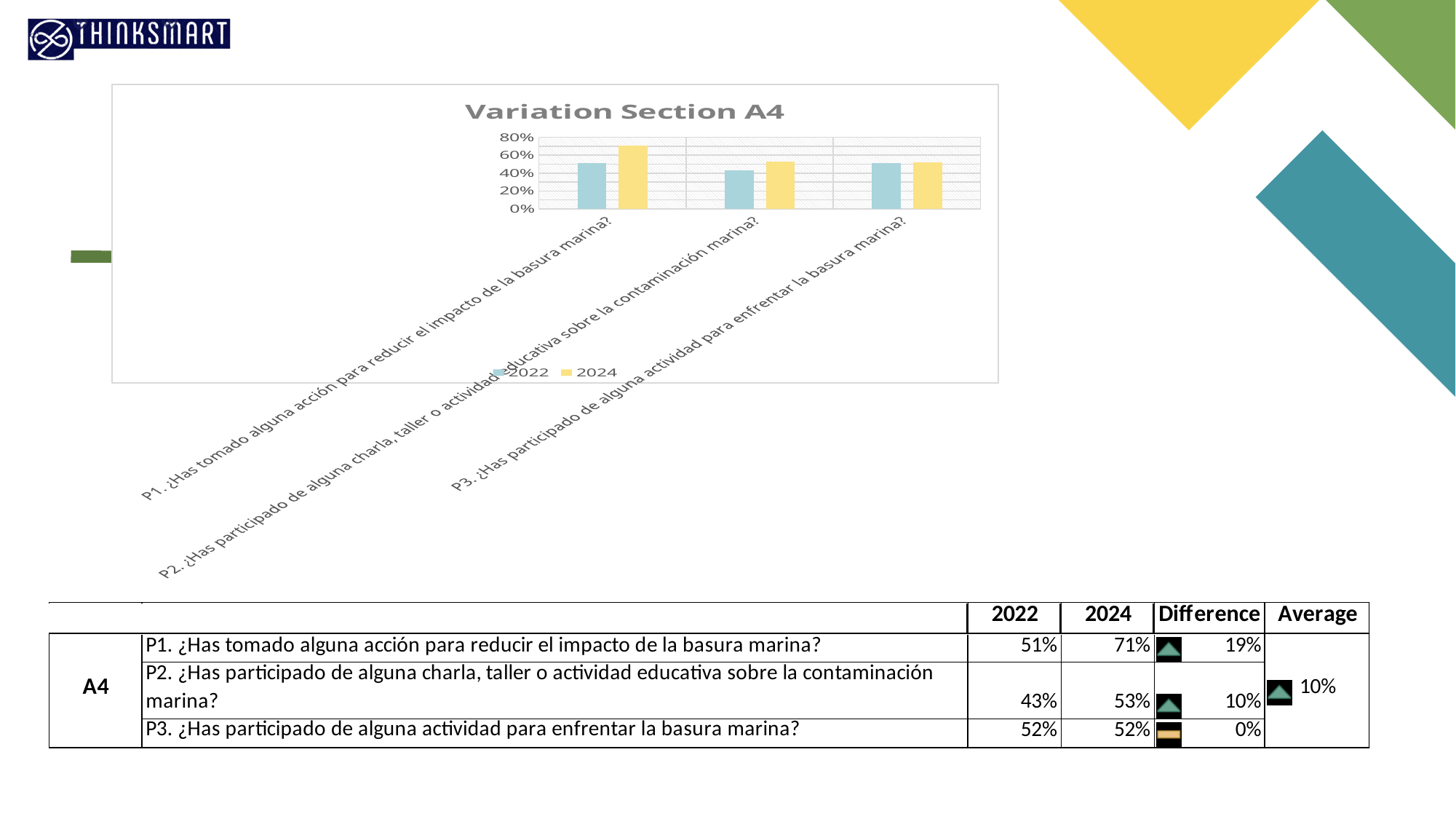
Which category and series has the highest bar in the chart? P1, 2024 What kind of chart is shown on the slide? bar chart What is the 2022 value for P2 (¿Has participado de alguna charla, taller o actividad educativa sobre la contaminación marina?)? 43% For P1, which is larger, the 2022 bar or the 2024 bar? 2024 What is the difference between the 2024 and 2022 values for P2? 10% Is the 2024 value for P1 greater or less than 60%? greater What is the 2024 value for P1 (¿Has tomado alguna acción para reducir el impacto de la basura marina?)? 71% How many categories (questions) are plotted on the x axis of the chart? 3 How many series does the chart legend list? 2 Which category has the lowest 2022 bar in the chart? P2 What is the title of the chart? Variation Section A4 Which series is shown in yellow in the chart? 2024